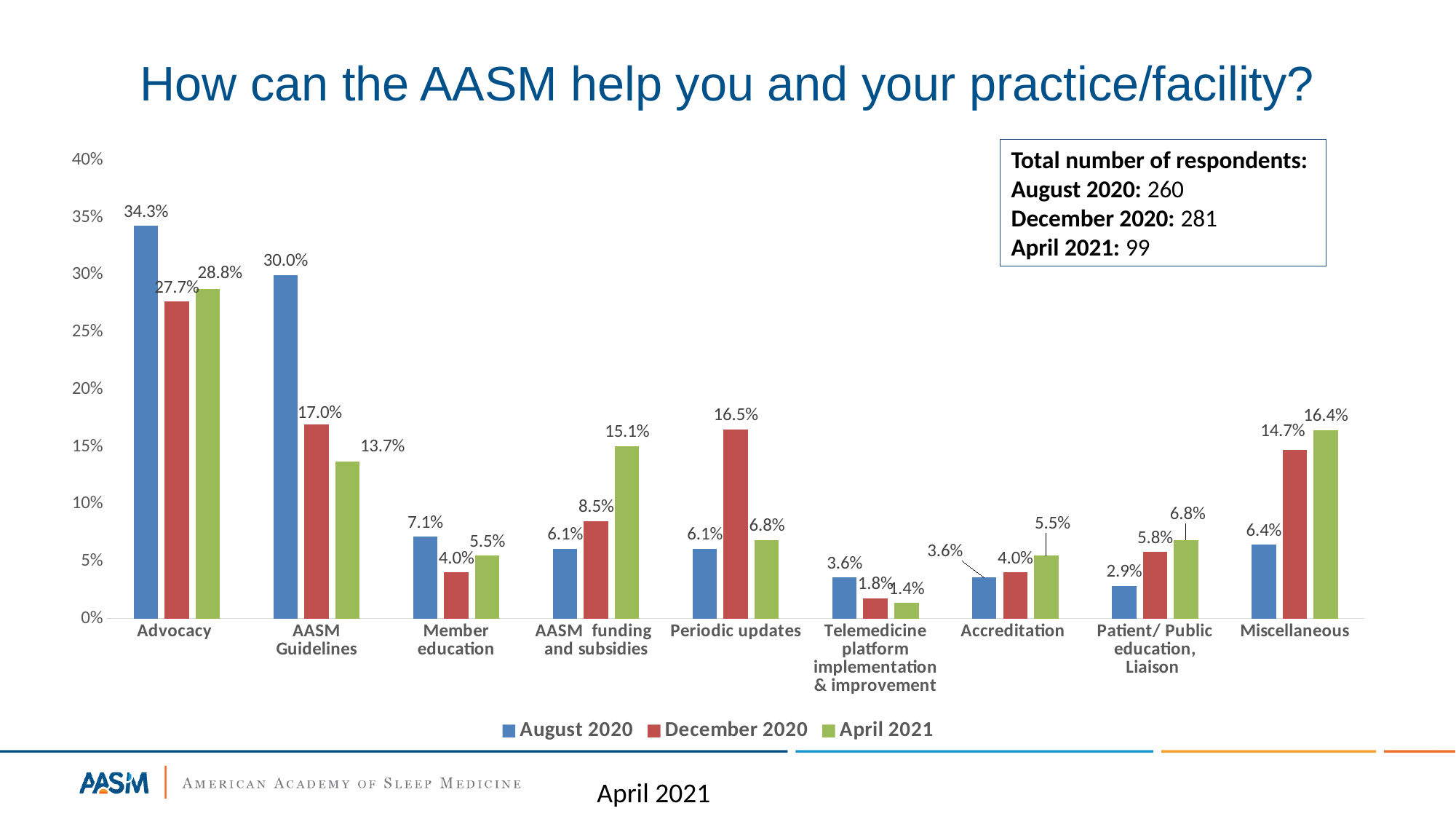
What is the value for Periodic updates in December 2020? 16.5% Which category has the highest value for August 2020? Advocacy Which category has the lowest value for April 2021? Telemedicine platform implementation & improvement What is the difference between the August 2020 and December 2020 values for AASM Guidelines? 13.0% Is the value for Advocacy in April 2021 greater or less than 25%? greater Which is larger for Miscellaneous: the December 2020 value or the April 2021 value? April 2021 What kind of chart is shown on the slide? bar chart What is the value for Advocacy in August 2020? 34.3% What is the total number of respondents for April 2021 shown in the text box? 99 How many categories are shown on the x axis? 9 How many series does the legend list? 3 What is the value for AASM funding and subsidies in April 2021? 15.1%